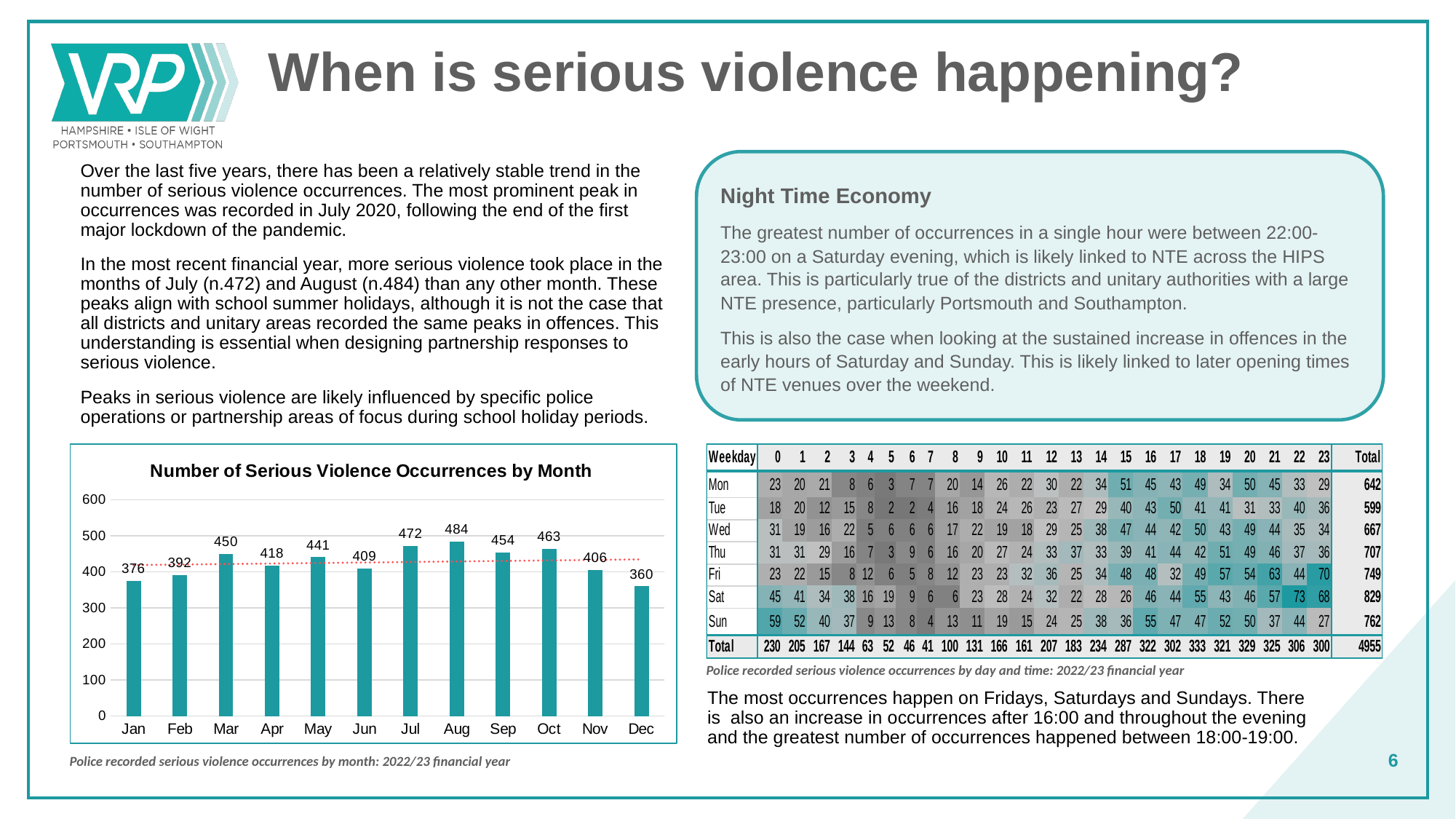
In the chart 'Number of Serious Violence Occurrences by Month', which is larger, the value for Mar or the value for Apr? Mar Which month has the lowest value in the chart 'Number of Serious Violence Occurrences by Month'? Dec What is the difference between the values for Jul and Jun in the chart 'Number of Serious Violence Occurrences by Month'? 63 In the chart 'Number of Serious Violence Occurrences by Month', is the value for Feb greater or less than 400? less What is the title of the bar chart on the slide? Number of Serious Violence Occurrences by Month Which month has the highest value in the chart 'Number of Serious Violence Occurrences by Month'? Aug How many months are shown on the x axis of the chart 'Number of Serious Violence Occurrences by Month'? 12 What is the value for Aug in the chart 'Number of Serious Violence Occurrences by Month'? 484 What is the difference between the values for Aug and Dec in the chart 'Number of Serious Violence Occurrences by Month'? 124 What is the value for Oct in the chart 'Number of Serious Violence Occurrences by Month'? 463 What kind of chart is 'Number of Serious Violence Occurrences by Month'? bar chart What is the value for Jan in the chart 'Number of Serious Violence Occurrences by Month'? 376